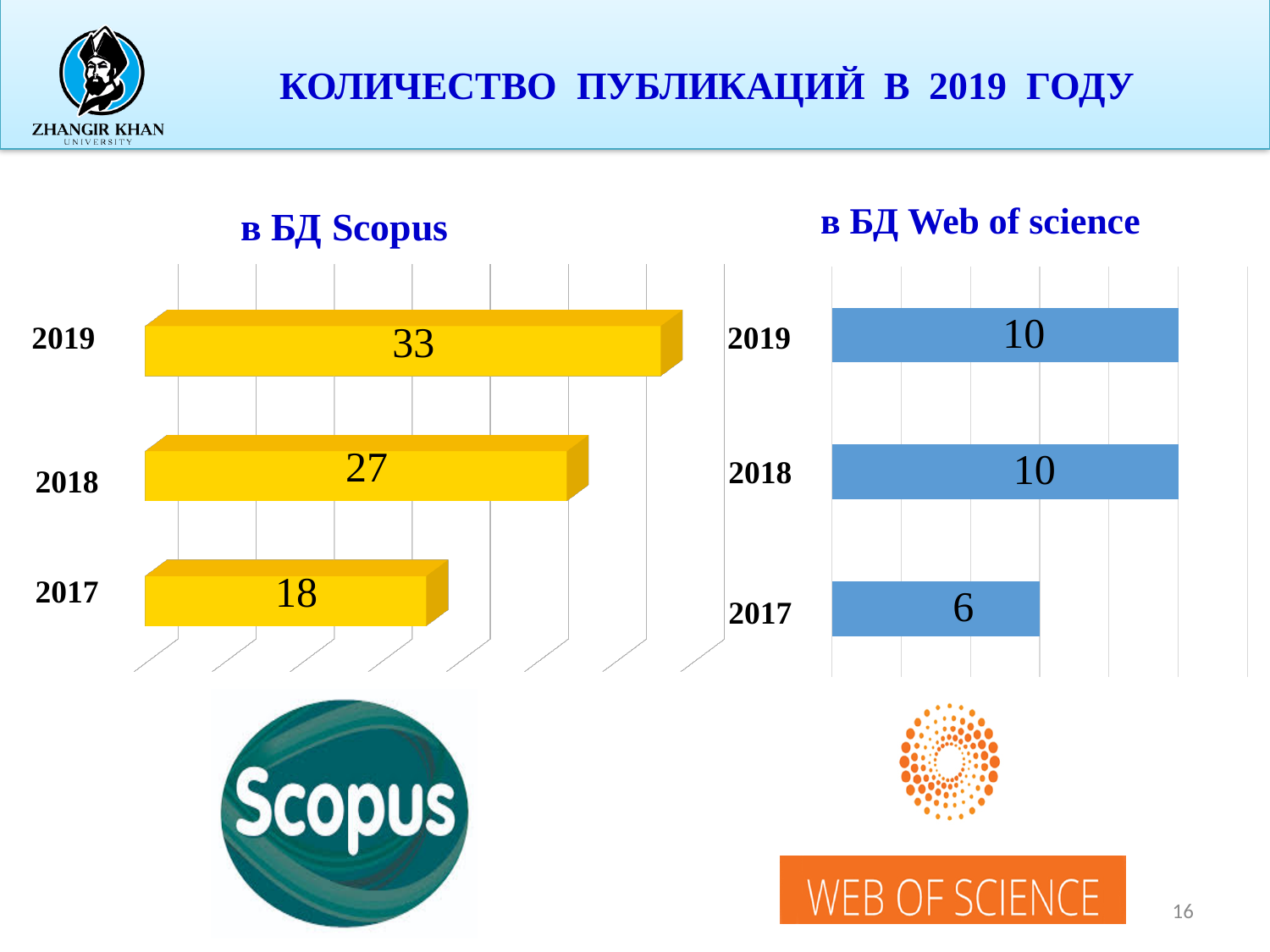
In the 'в БД Scopus' chart, which is larger, the value for 2018 or the value for 2017? 2018 In the 'в БД Scopus' chart, what is the difference between the values for 2019 and 2018? 6 In the 'в БД Scopus' chart, which year has the highest value? 2019 In the 'в БД Scopus' chart, what is the value for 2019? 33 In the 'в БД Web of science' chart, what is the difference between the values for 2018 and 2017? 4 In the 'в БД Web of science' chart, what is the value for 2017? 6 In the 'в БД Web of science' chart, what is the value for 2018? 10 In the 'в БД Web of science' chart, which year has the lowest value? 2017 How many years are shown in the 'в БД Scopus' chart? 3 What kind of chart is the 'в БД Web of science' chart? bar chart In the 'в БД Scopus' chart, do the values rise or fall from 2017 to 2019? rise In the 'в БД Scopus' chart, what is the value for 2017? 18